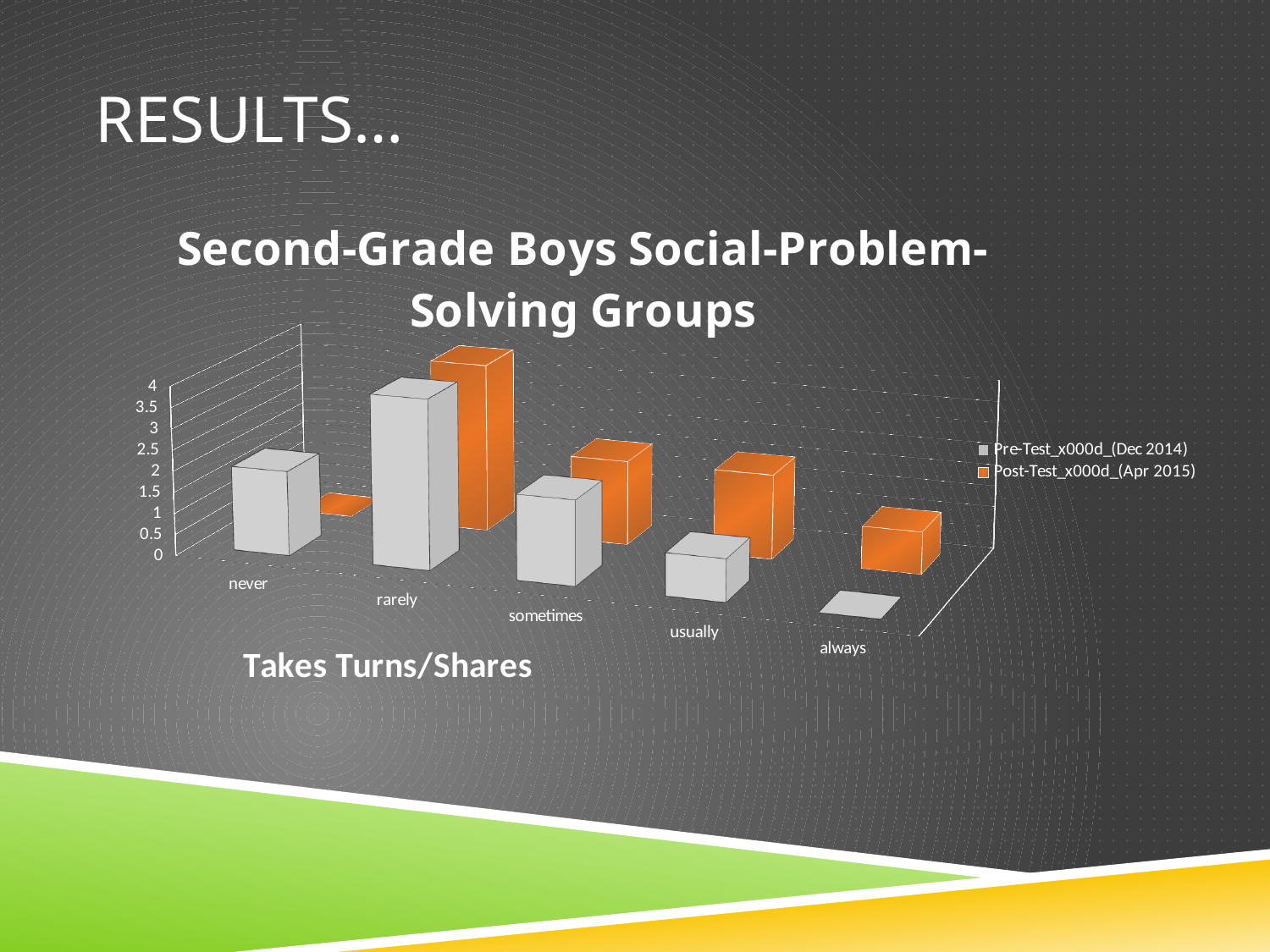
What kind of chart is shown on the slide? bar chart Which category has the highest Pre-Test (Dec 2014) value? rarely What label is shown beneath the x axis of the chart? Takes Turns/Shares Is the Post-Test (Apr 2015) value for never greater or less than 1? less How many series does the chart's legend list? 2 Which category has the lowest Post-Test (Apr 2015) value? never What is the title of the chart? Second-Grade Boys Social-Problem-Solving Groups Is the Pre-Test (Dec 2014) value for rarely greater or less than 2? greater Which category has the lowest Pre-Test (Dec 2014) value? always How many categories are shown on the x axis of the chart? 5 Which category has the highest Post-Test (Apr 2015) value? rarely Which is larger, the Pre-Test (Dec 2014) value for rarely or the Pre-Test (Dec 2014) value for usually? rarely